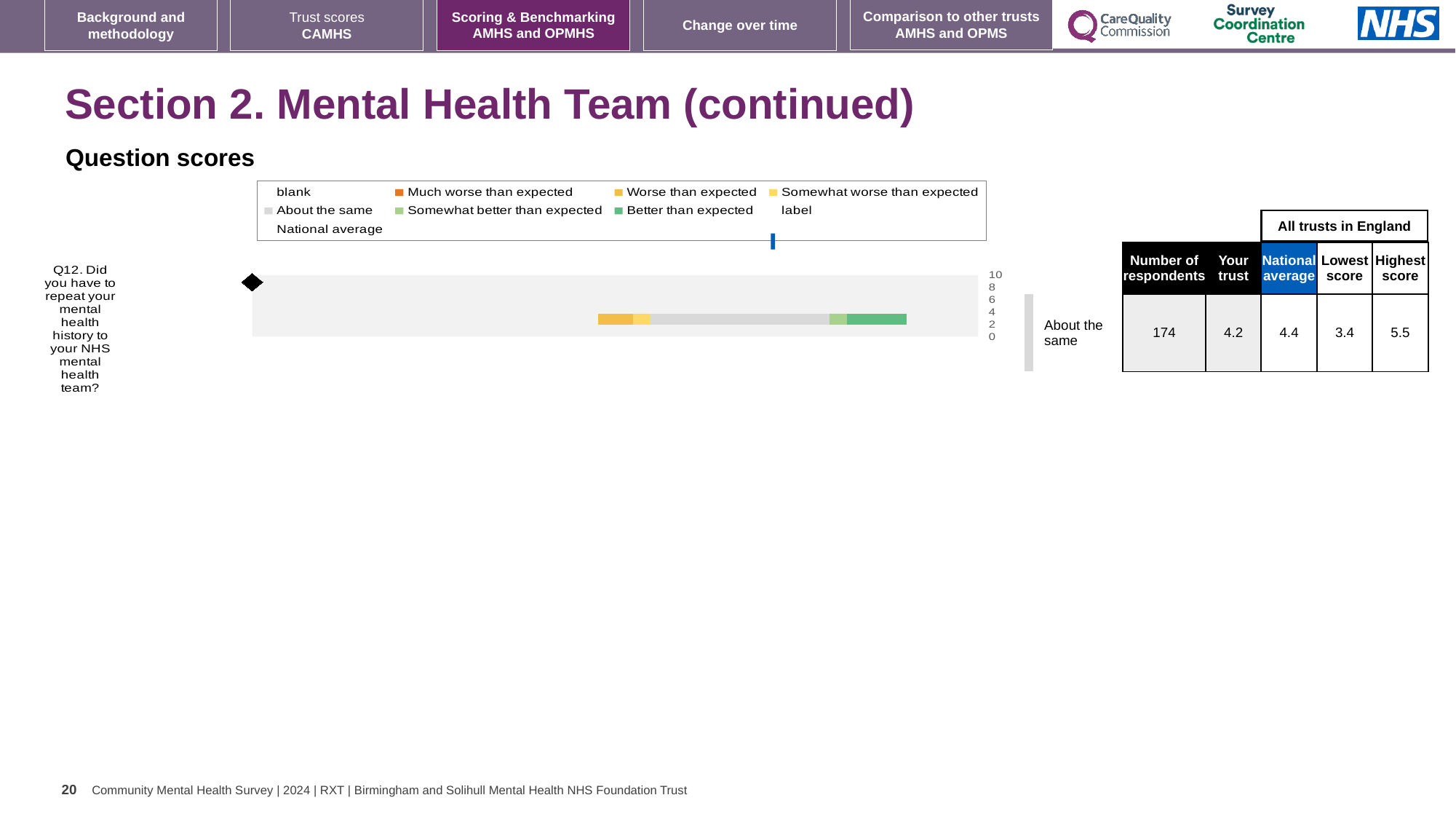
What is the lowest score among all trusts in England for Q12? 3.4 How many questions are plotted in the Question scores chart? 1 What is the 'Your trust' score for Q12? 4.2 How many entries does the legend of the Question scores chart list? 9 What kind of chart is used to show the Q12 question score? Bar chart What is the highest score among all trusts in England for Q12? 5.5 What is the difference between the national average and the trust's score for Q12? 0.2 What is the difference between the highest and lowest scores among all trusts in England for Q12? 2.1 What is the national average score for Q12? 4.4 How many respondents answered Q12? 174 Which benchmarking category is the trust's Q12 score placed in? About the same Which is larger for Q12, the trust's score or the national average? National average